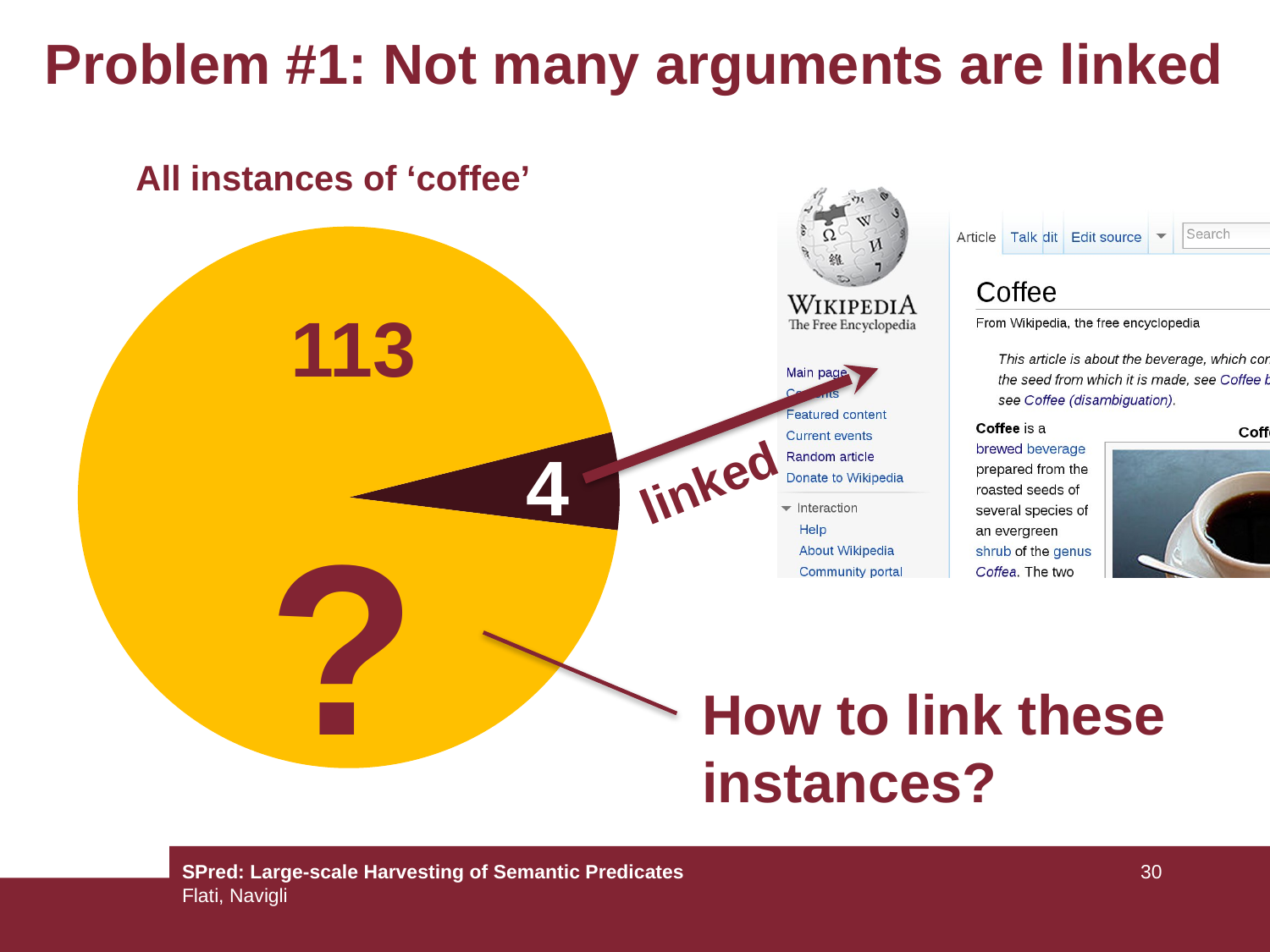
What is the total of the two slice values in the pie chart? 117 How many slices does the pie chart have? 2 What is the difference between the two slice values in the pie chart? 109 Which slice of the pie chart is the largest? the yellow slice (113) What value is printed on the small dark slice labelled 'linked'? 4 What is the title of the pie chart? All instances of 'coffee' What symbol is printed on the large yellow slice of the pie chart? ? Which slice of the pie chart is the smallest? the linked slice (4) How many instances of 'coffee' are linked according to the pie chart? 4 What kind of chart is shown on the slide? pie chart Is the linked slice larger or smaller than the yellow slice? smaller What value is printed on the large yellow slice of the pie chart? 113